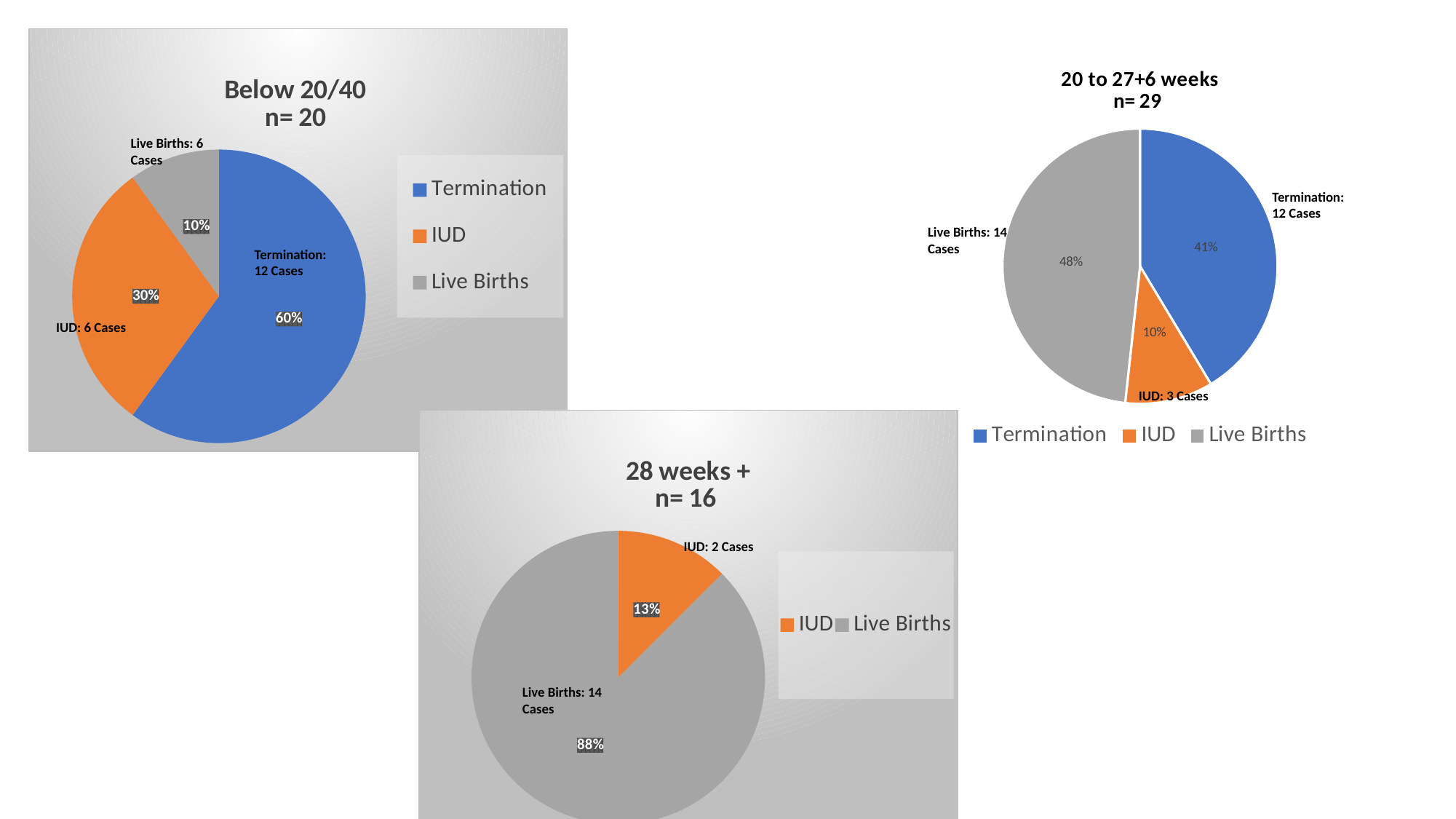
In the 'Below 20/40 n= 20' chart, which category has the smallest slice? Live Births In the '20 to 27+6 weeks n= 29' chart, which colour represents Termination? Blue In the '28 weeks + n= 16' chart, what percentage share does IUD have? 13% In the 'Below 20/40 n= 20' chart, what percentage share does Termination have? 60% In the '28 weeks + n= 16' chart, how many categories does the legend list? 2 What kind of chart is the '28 weeks + n= 16' chart? Pie chart In the '28 weeks + n= 16' chart, how many cases are labelled for Live Births? 14 Cases In the 'Below 20/40 n= 20' chart, how many cases are labelled for IUD? 6 Cases In the '20 to 27+6 weeks n= 29' chart, how many cases are labelled for IUD? 3 Cases In the '20 to 27+6 weeks n= 29' chart, what percentage share does Live Births have? 48% In the 'Below 20/40 n= 20' chart, what is the difference in cases between Termination and IUD? 6 In the '20 to 27+6 weeks n= 29' chart, which category has the largest slice? Live Births